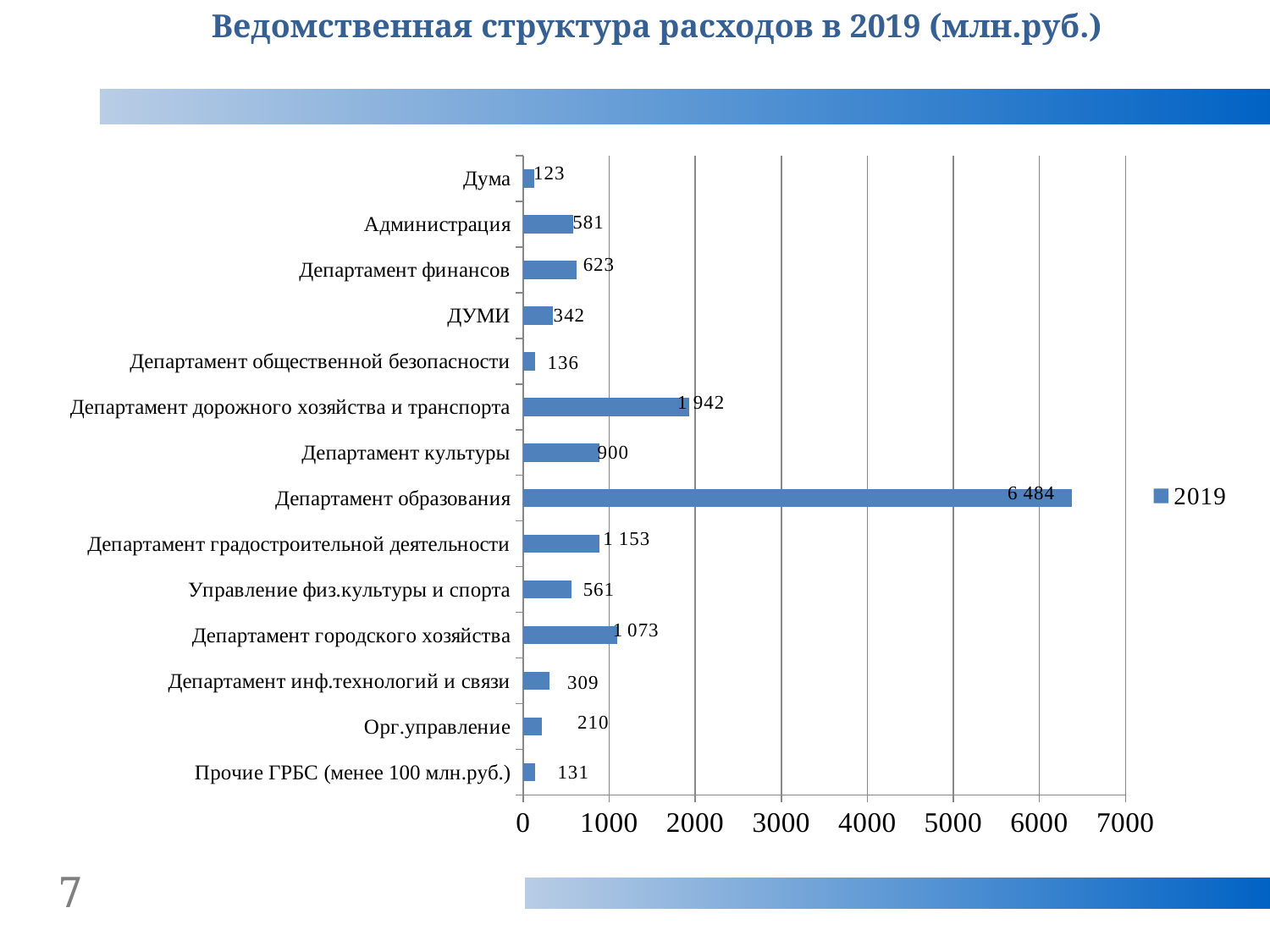
What is the difference between Департамент финансов and Администрация? 42 How many categories are shown in the chart? 14 What is the value for Департамент дорожного хозяйства и транспорта? 1 942 How many series does the legend list? 1 What kind of chart is shown on the slide? bar chart Which is larger: Департамент городского хозяйства or Департамент культуры? Департамент городского хозяйства What is the value for Департамент образования? 6 484 What is the title of the chart? Ведомственная структура расходов в 2019 (млн.руб.) Which category has the highest value? Департамент образования Which category has the lowest value? Дума What is the value for Орг.управление? 210